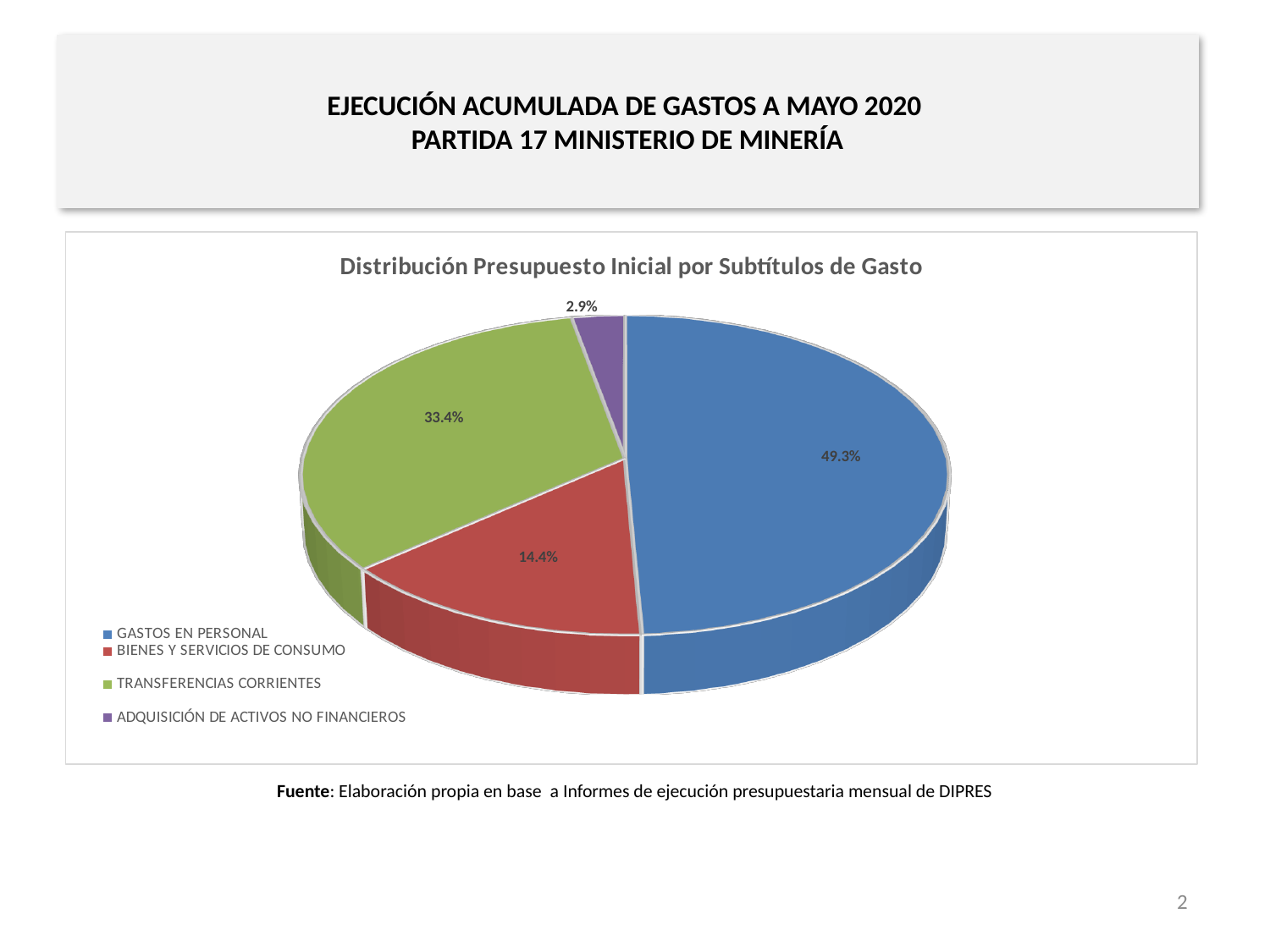
Which category has the largest share of the pie? GASTOS EN PERSONAL What is the title of the chart? Distribución Presupuesto Inicial por Subtítulos de Gasto What share of the pie does GASTOS EN PERSONAL represent? 49.3% Which is larger, the share of BIENES Y SERVICIOS DE CONSUMO or the share of TRANSFERENCIAS CORRIENTES? TRANSFERENCIAS CORRIENTES What share of the pie does ADQUISICIÓN DE ACTIVOS NO FINANCIEROS represent? 2.9% What share of the pie does TRANSFERENCIAS CORRIENTES represent? 33.4% What type of chart is shown on the slide? Pie chart What colour is the slice for TRANSFERENCIAS CORRIENTES? Green How many categories does the pie chart have? 4 What is the difference between the shares of GASTOS EN PERSONAL and TRANSFERENCIAS CORRIENTES? 15.9% Which category has the smallest share of the pie? ADQUISICIÓN DE ACTIVOS NO FINANCIEROS